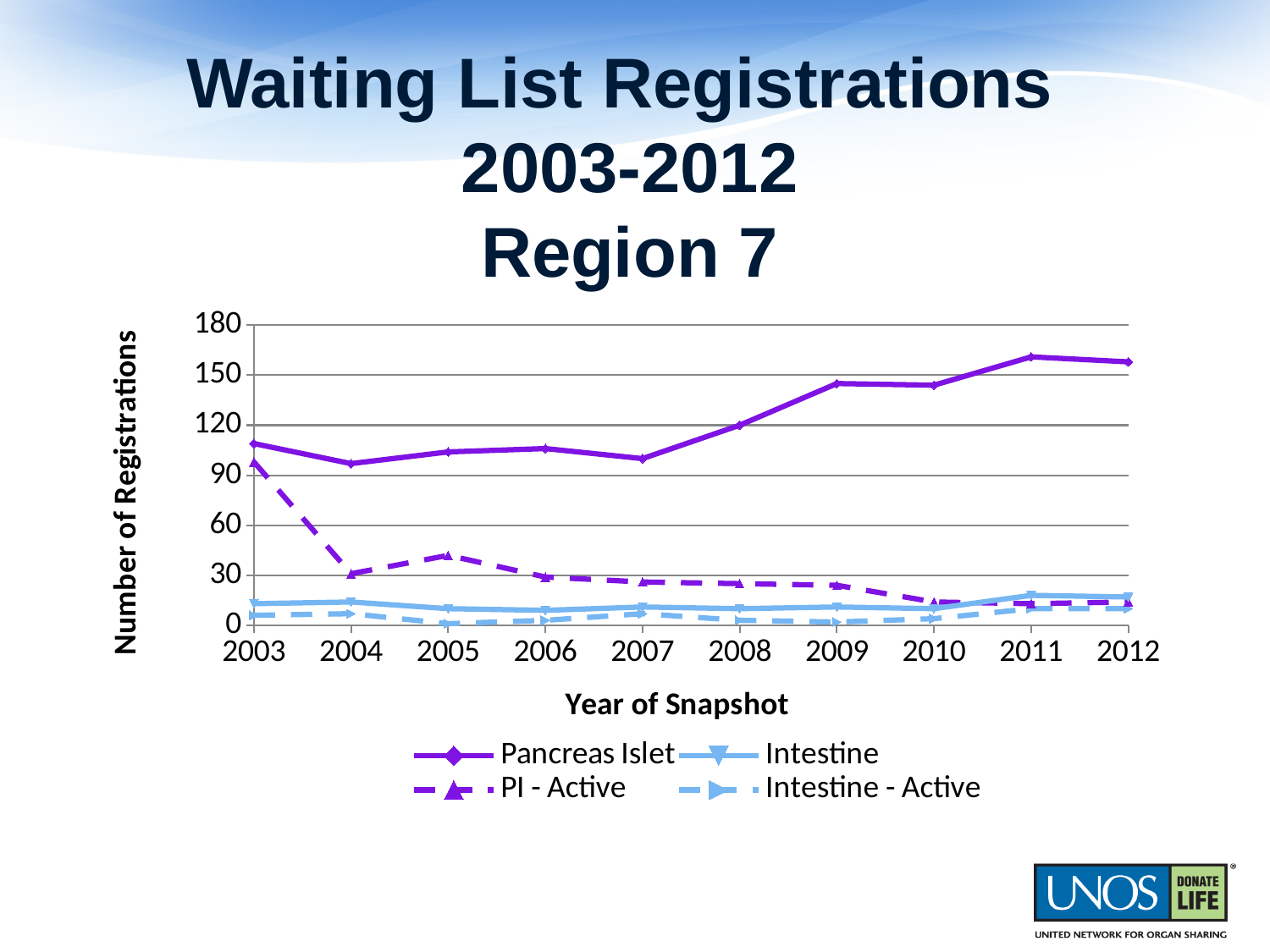
Is the value for Pancreas Islet in 2003 greater or less than 120? less What is the title of the x axis? Year of Snapshot Is the value for Intestine in 2011 greater or less than 30? less In which year is the PI - Active series at its highest? 2003 Does the Pancreas Islet series rise or fall from 2007 to 2011? rise How many years are plotted along the x axis? 10 What kind of chart is shown on the slide? line chart Is the value for PI - Active in 2004 greater or less than 60? less In 2009, which series has the larger value: Pancreas Islet or PI - Active? Pancreas Islet Does the PI - Active series generally rise or fall from 2003 to 2010? fall How many series does the legend list? 4